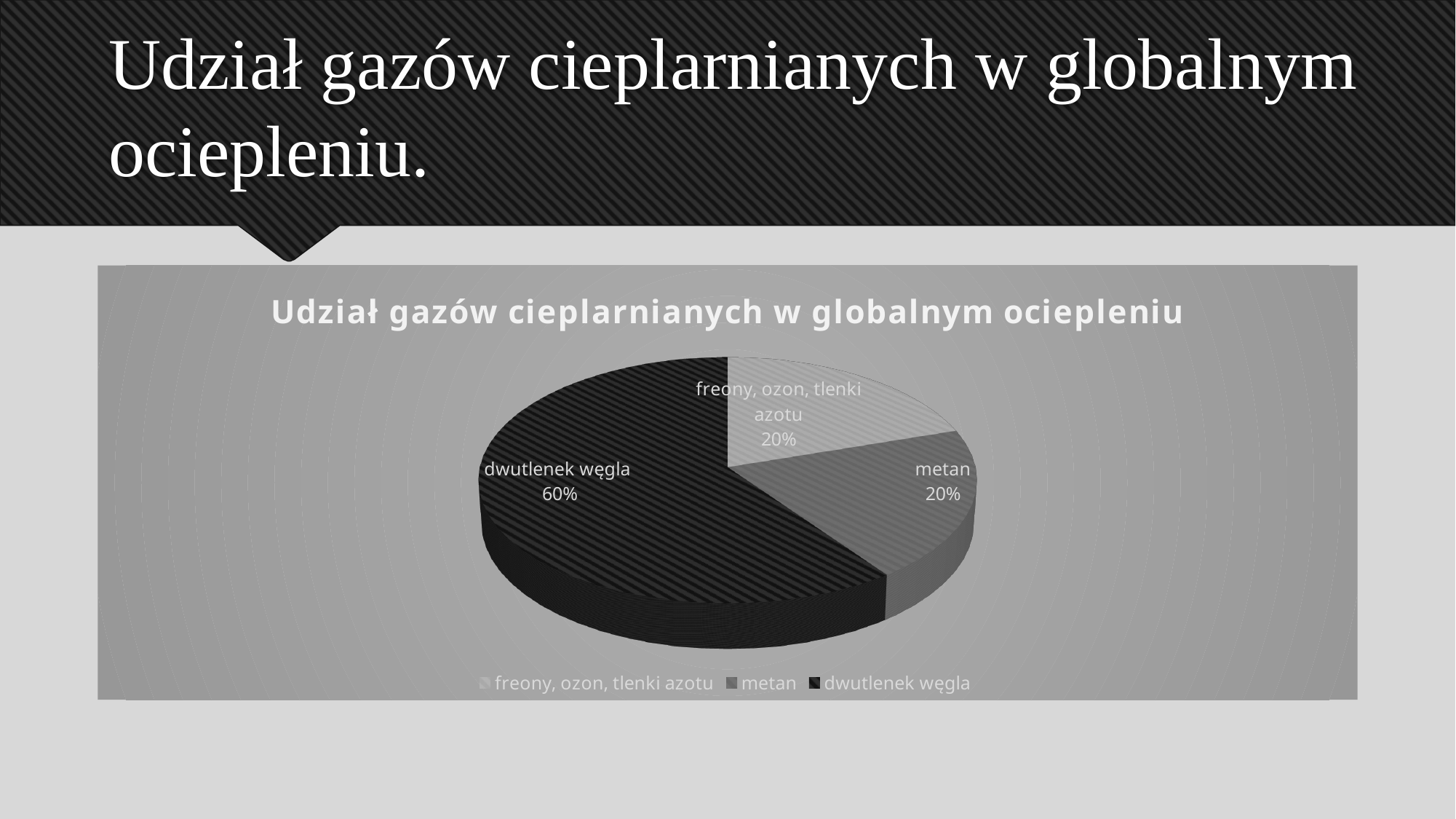
Which category has the largest slice of the pie? dwutlenek węgla Which is larger, the share for dwutlenek węgla or the share for freony, ozon, tlenki azotu? dwutlenek węgla What kind of chart is shown on the slide? pie chart What share of the pie does freony, ozon, tlenki azotu have? 20% Is the share for dwutlenek węgla greater or less than 50%? greater What is the difference in percentage points between dwutlenek węgla and metan? 40 How many slices does the pie chart have? 3 What is the title of the chart? Udział gazów cieplarnianych w globalnym ociepleniu What share of the pie does metan have? 20% How many entries does the legend list? 3 What is the combined share of metan and freony, ozon, tlenki azotu? 40% What share of the pie does dwutlenek węgla have? 60%